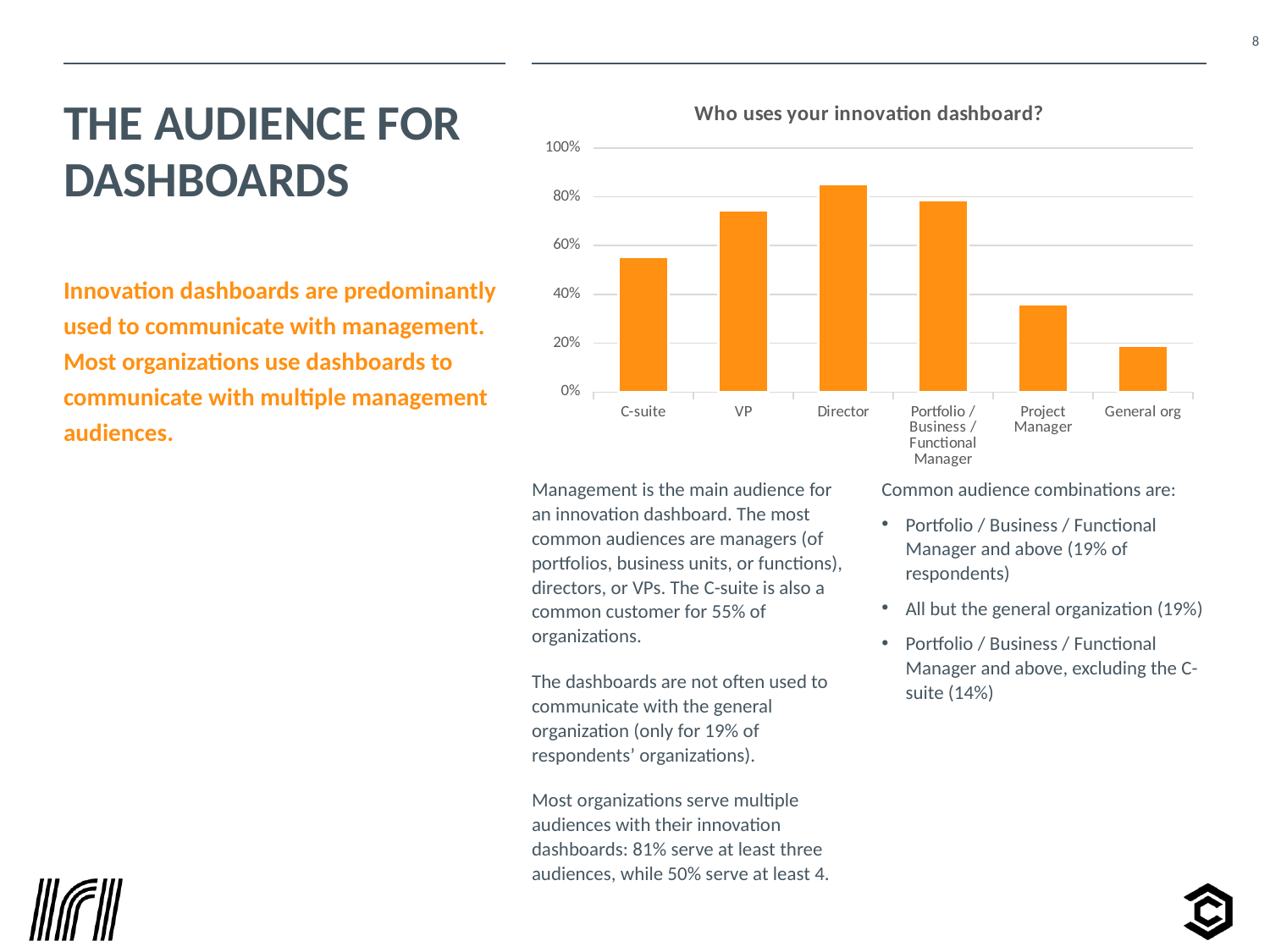
Is the value for Project Manager greater or less than 40%? less Which category has the highest value in the chart? Director Which has a larger value, C-suite or Portfolio / Business / Functional Manager? Portfolio / Business / Functional Manager What colour are the bars in the chart? orange What is the title of the chart? Who uses your innovation dashboard? Which has a larger value, VP or Project Manager? VP Which category has the lowest value in the chart? General org Is the value for C-suite greater or less than 60%? less What kind of chart is shown on the slide? bar chart Is the value for Director greater or less than 80%? greater How many categories are shown on the x axis of the chart? 6